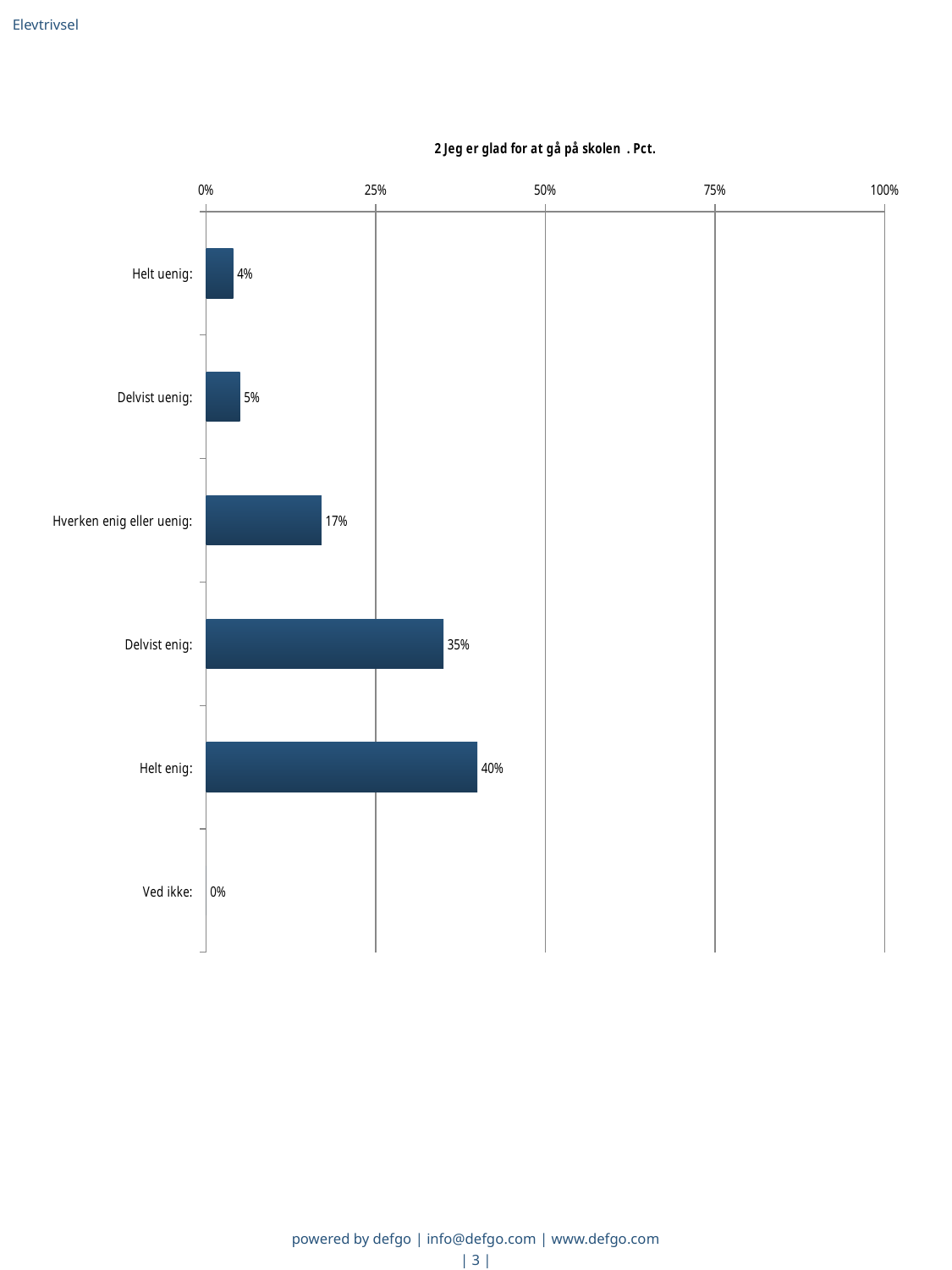
Which category has the highest value? Helt enig What is the value for "Delvist uenig"? 5% What is the value for "Helt enig"? 40% What is the difference between the values for "Helt enig" and "Delvist enig"? 5% Which category has the lowest value? Ved ikke How many categories are shown in the chart? 6 What kind of chart is shown on the slide? Bar chart What is the title of the chart? 2 Jeg er glad for at gå på skolen . Pct. Which is larger, the value for "Hverken enig eller uenig" or the value for "Delvist uenig"? Hverken enig eller uenig Is the value for "Delvist enig" greater or less than 25%? greater What is the value for "Ved ikke"? 0% What is the value for "Hverken enig eller uenig"? 17%